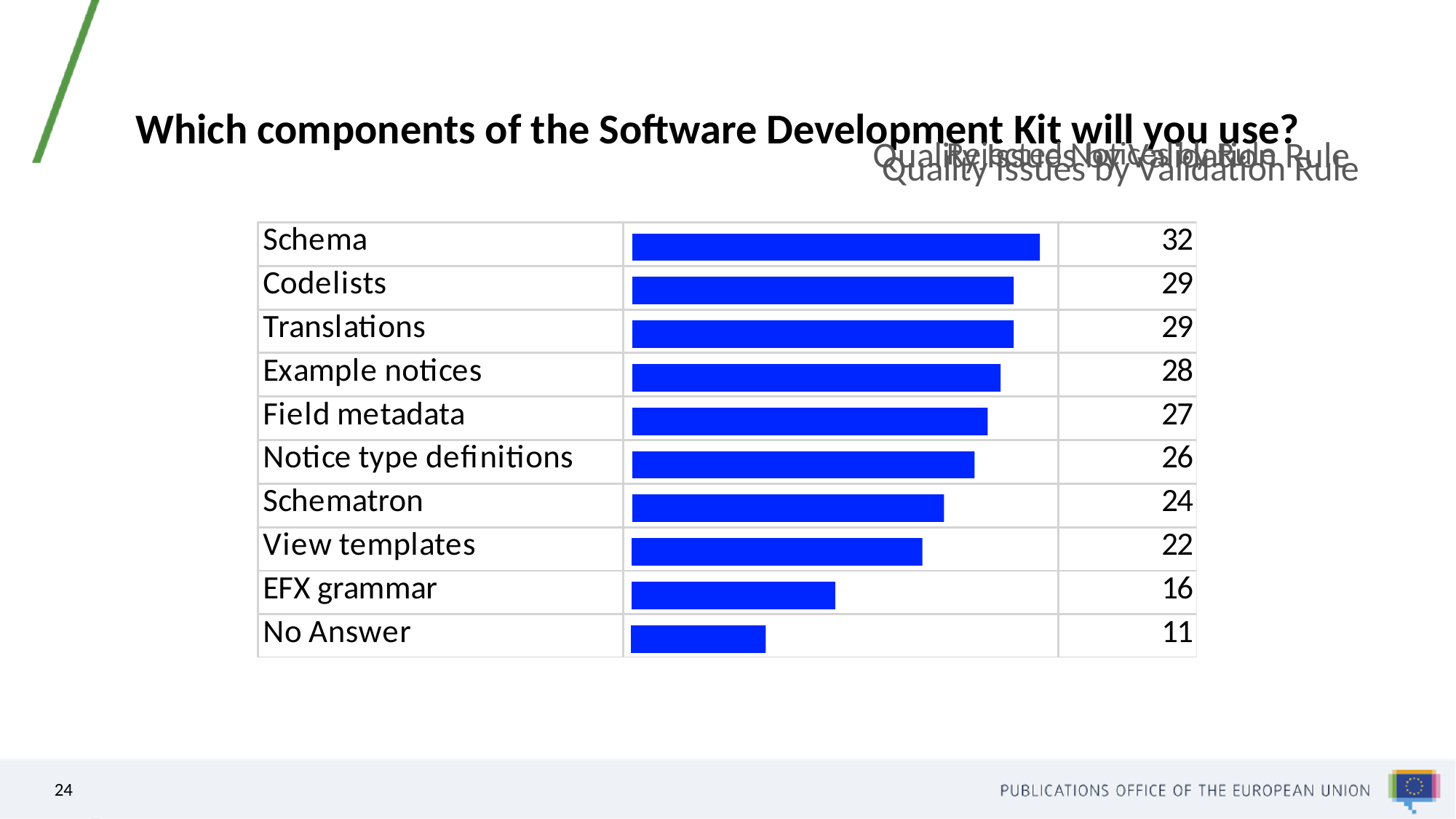
How many categories are shown in the chart? 10 What is the difference between the values for Schematron and View templates? 2 Which is larger, the value for Field metadata or the value for EFX grammar? Field metadata Do the values rise or fall going down the list of categories from Schema to No Answer? fall What is the value for EFX grammar? 16 Which category has the lowest value? No Answer What is the value for Schema? 32 Which category has the highest value? Schema What is the difference between the values for Schema and No Answer? 21 What is the value for Notice type definitions? 26 What kind of chart is shown on the slide? bar chart What colour are the bars in the chart? blue